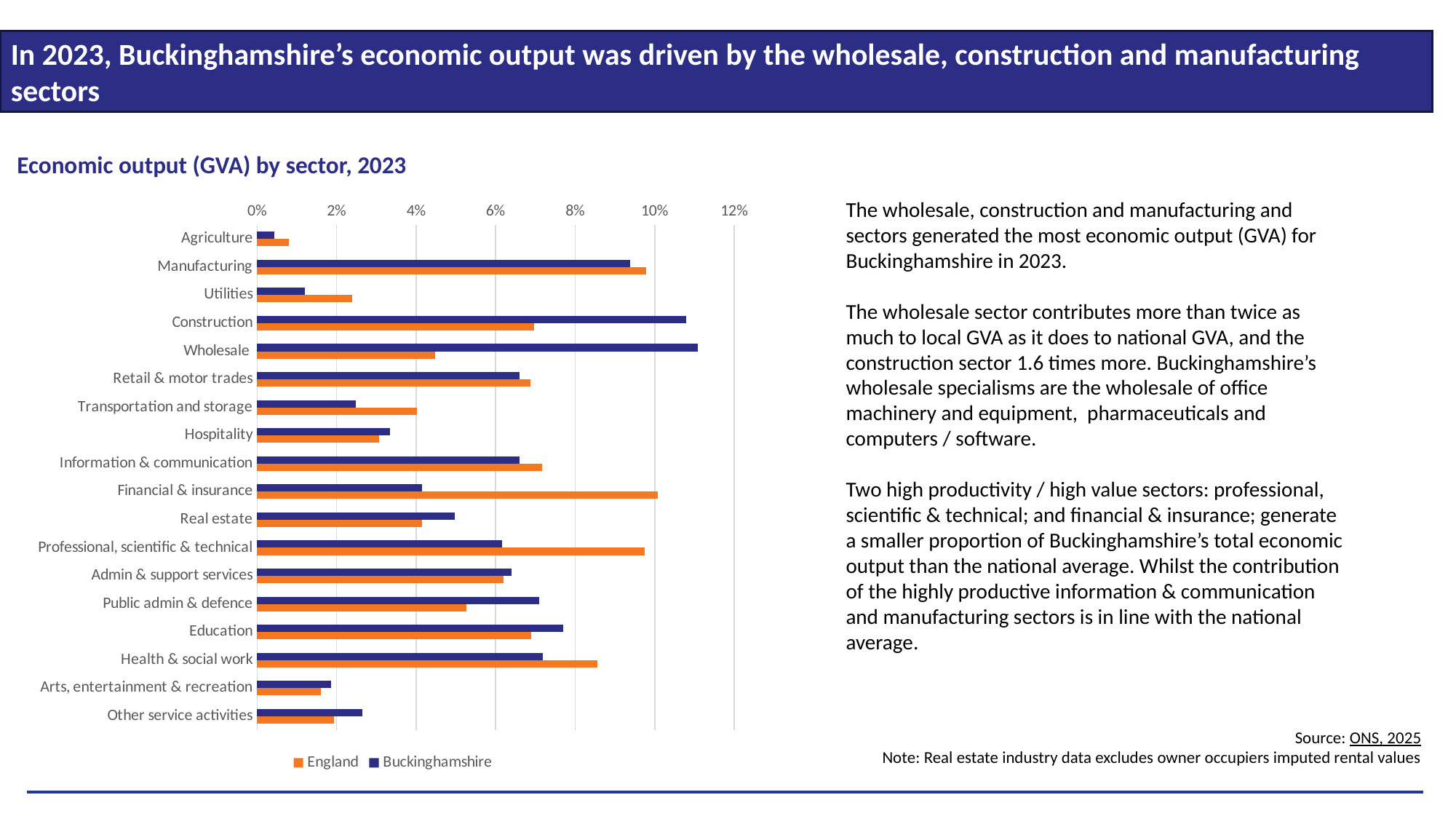
How many sectors are shown on the chart? 18 Which sector has the lowest England value? Agriculture Which sector has the lowest Buckinghamshire value? Agriculture Is the England value for Financial & insurance greater or less than 8%? greater What is the title of the chart? Economic output (GVA) by sector, 2023 Is the England value for Wholesale greater or less than 6%? less For Professional, scientific & technical, which is larger: the England value or the Buckinghamshire value? England How many series does the legend list? 2 Which sector has the highest Buckinghamshire value? Wholesale For Construction, which is larger: the England value or the Buckinghamshire value? Buckinghamshire Is the Buckinghamshire value for Wholesale greater or less than 10%? greater What kind of chart is shown on the slide? Bar chart